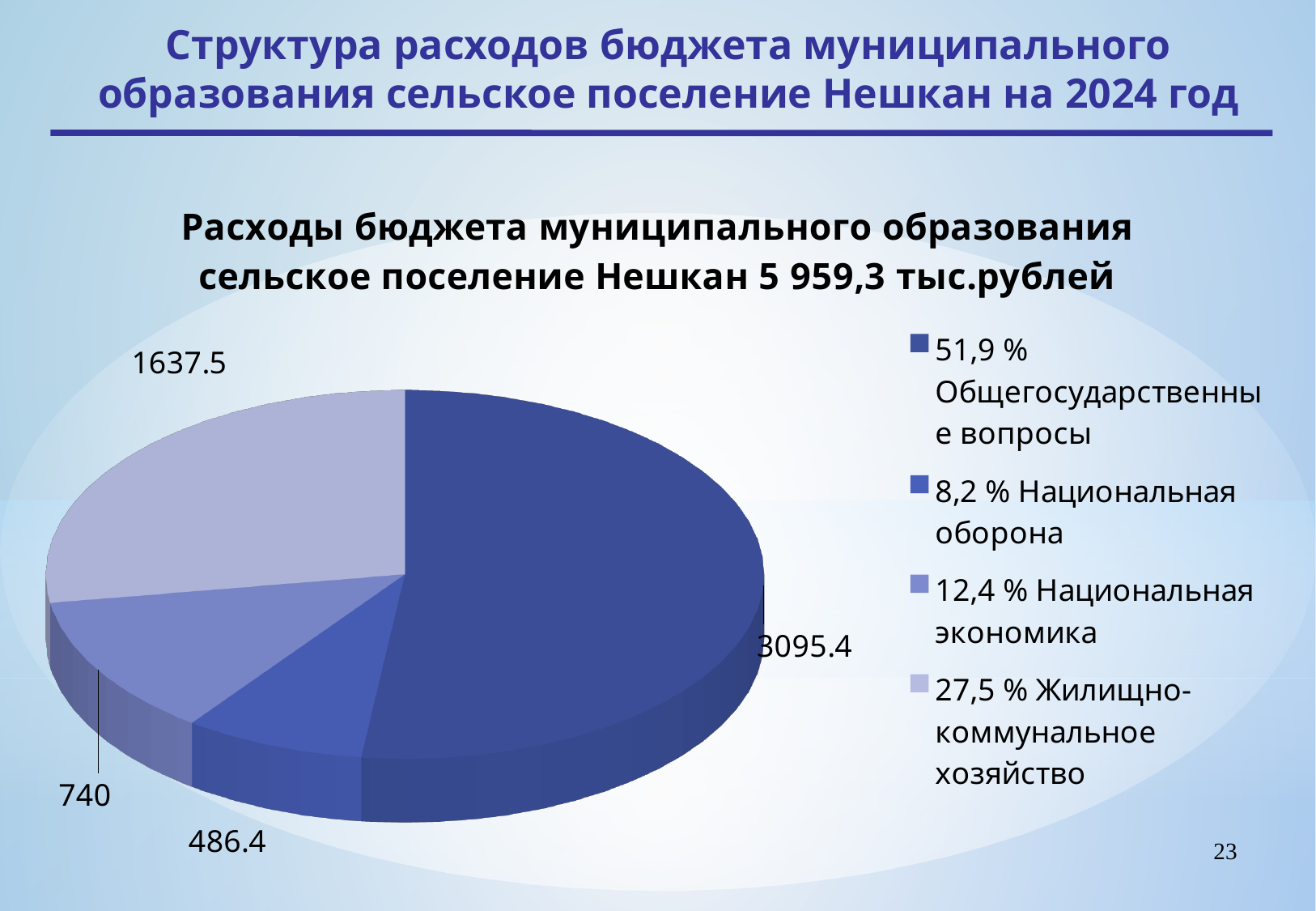
Which category has the largest slice? Общегосударственные вопросы What is the value for Общегосударственные вопросы? 3095.4 Which is larger, the value for Национальная экономика or the value for Национальная оборона? Национальная экономика What is the value for Национальная экономика? 740 What is the value for Жилищно-коммунальное хозяйство? 1637.5 Which category has the smallest slice? Национальная оборона What is the difference between the values for Общегосударственные вопросы and Жилищно-коммунальное хозяйство? 1457.9 What is the value for Национальная оборона? 486.4 How many entries does the legend list? 4 How many slices does the pie chart have? 4 What type of chart is shown on the slide? pie chart What share of the pie does Жилищно-коммунальное хозяйство represent, as shown in the legend? 27,5 %